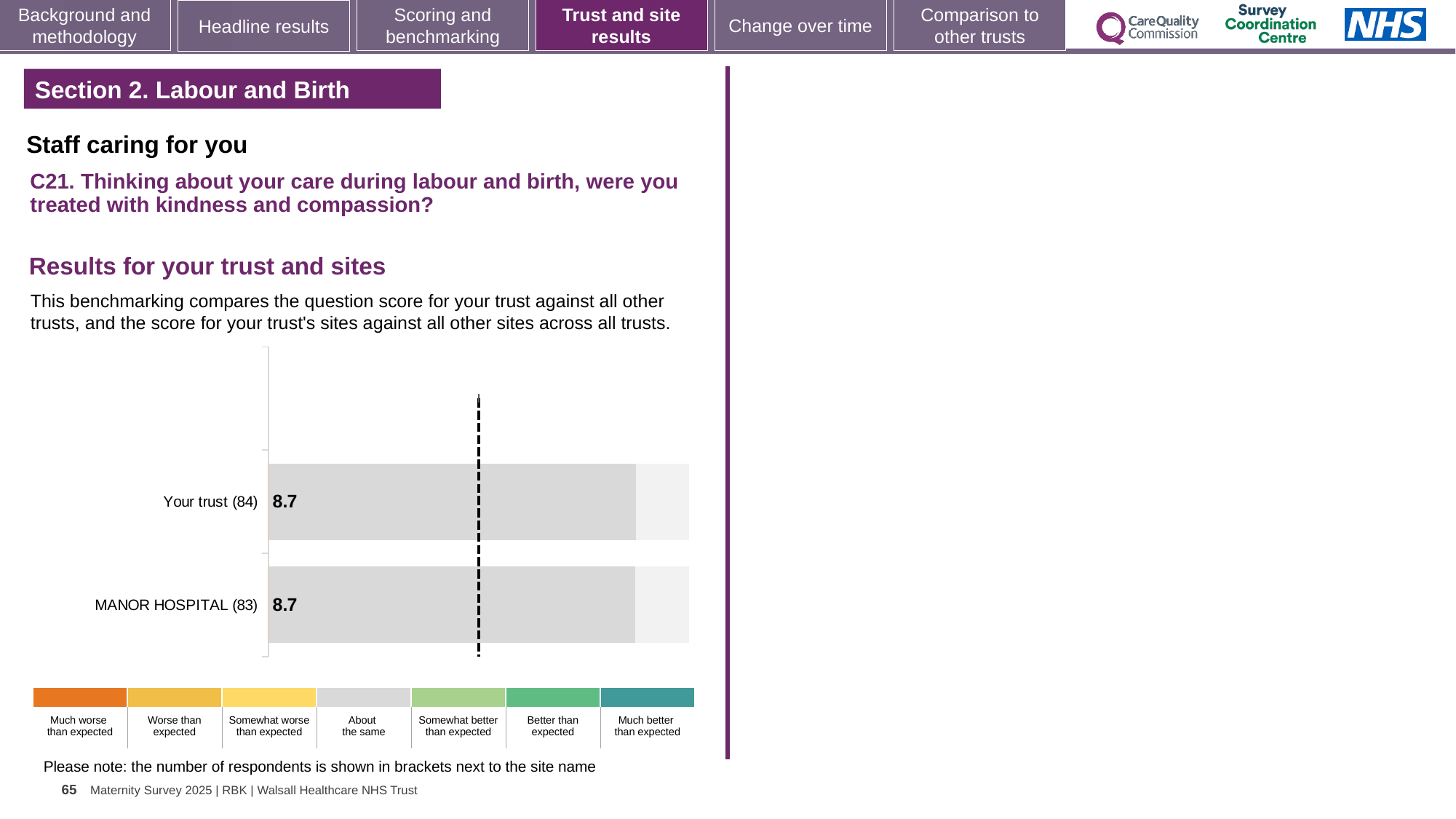
Is the score for Your trust larger than, smaller than, or equal to the score for MANOR HOSPITAL? equal What is the score for Your trust? 8.7 What is the difference between the score for Your trust and the score for MANOR HOSPITAL? 0 What is the score for MANOR HOSPITAL? 8.7 What kind of chart is shown on the slide? bar chart How many rating categories does the colour key below the chart list? 7 How many respondents are shown in brackets next to MANOR HOSPITAL? 83 How many bars are plotted in the chart? 2